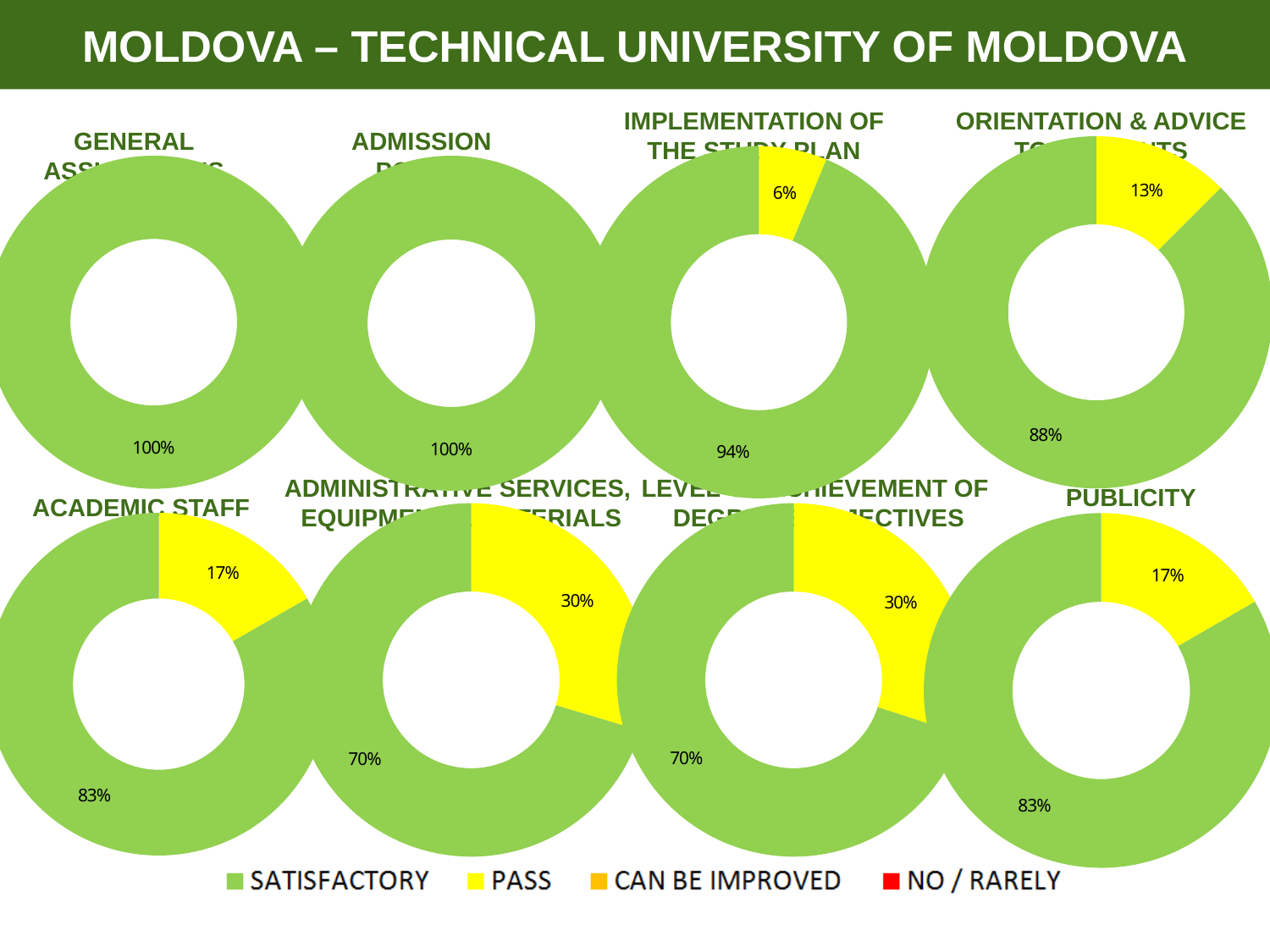
In the 'ACADEMIC STAFF' chart, what percentage is labelled for the PASS slice? 17% What kind of chart is used for 'ACADEMIC STAFF'? Doughnut chart In the 'IMPLEMENTATION OF THE STUDY PLAN' chart, what percentage is labelled for the SATISFACTORY slice? 94% Which is larger: the PASS share in the 'PUBLICITY' chart or the PASS share in the 'IMPLEMENTATION OF THE STUDY PLAN' chart? PUBLICITY In the 'IMPLEMENTATION OF THE STUDY PLAN' chart, which category has the largest slice? SATISFACTORY In the 'IMPLEMENTATION OF THE STUDY PLAN' chart, what percentage is labelled for the PASS slice? 6% In the 'PUBLICITY' chart, what percentage is labelled for the SATISFACTORY slice? 83% In the top-right chart (ORIENTATION & ADVICE), what percentage is labelled for the PASS slice? 13% In the second chart of the bottom row (ADMINISTRATIVE SERVICES), what percentage is labelled for the SATISFACTORY slice? 70% How many entries does the legend at the bottom of the slide list? 4 What colour represents SATISFACTORY in the legend? Green In the 'ACADEMIC STAFF' chart, what is the difference between the SATISFACTORY and PASS percentages? 66%